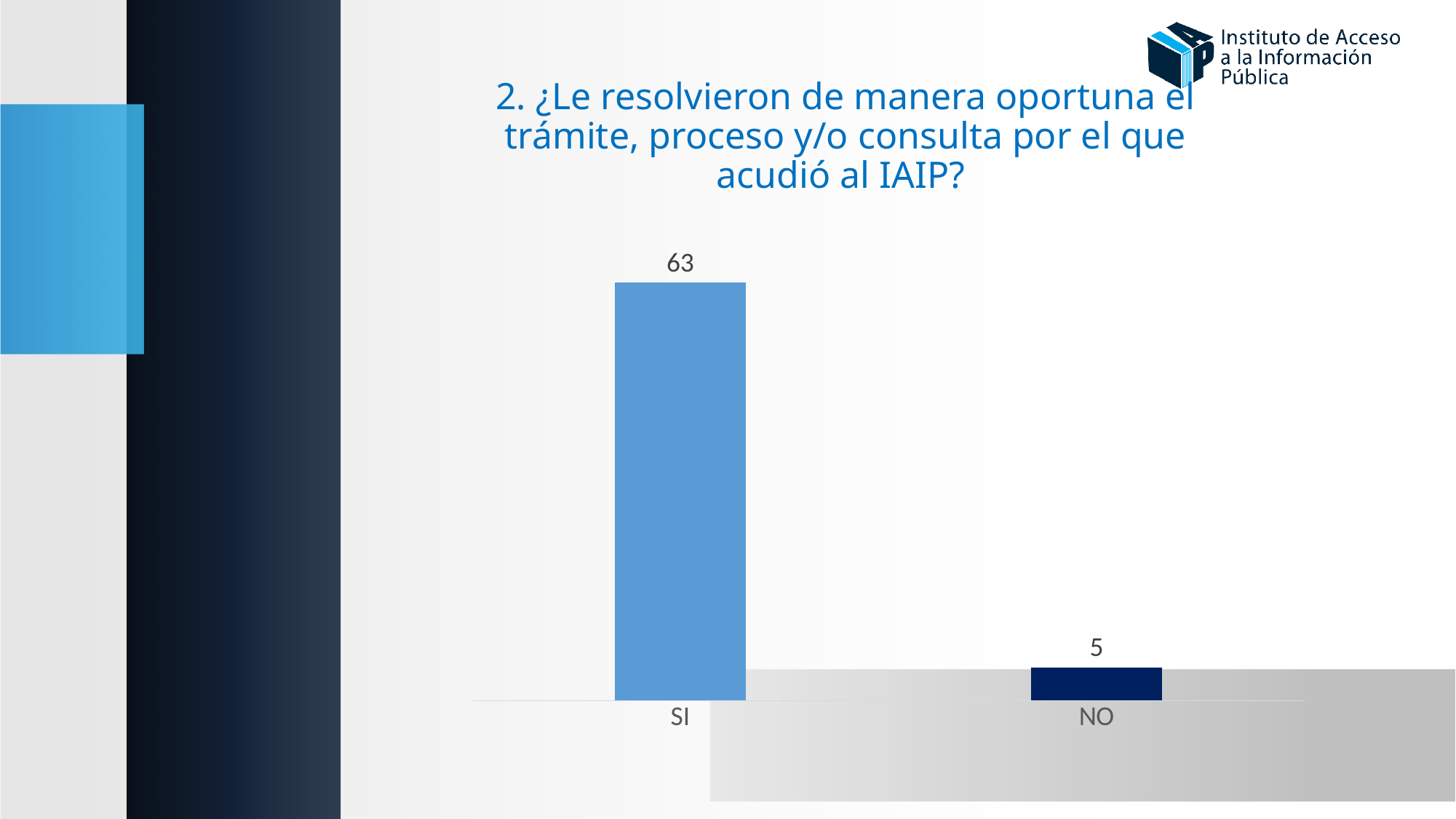
What colour is the bar for NO? Dark navy blue Which is larger, the value for SI or the value for NO? SI How many categories are shown in the chart? 2 What is the difference between the values for SI and NO? 58 What is the title of the chart? 2. ¿Le resolvieron de manera oportuna el trámite, proceso y/o consulta por el que acudió al IAIP? What is the value for SI? 63 Which category has the lowest value? NO What is the total of the values for SI and NO? 68 What is the value for NO? 5 Which category has the highest value? SI What kind of chart is shown on the slide? Bar chart